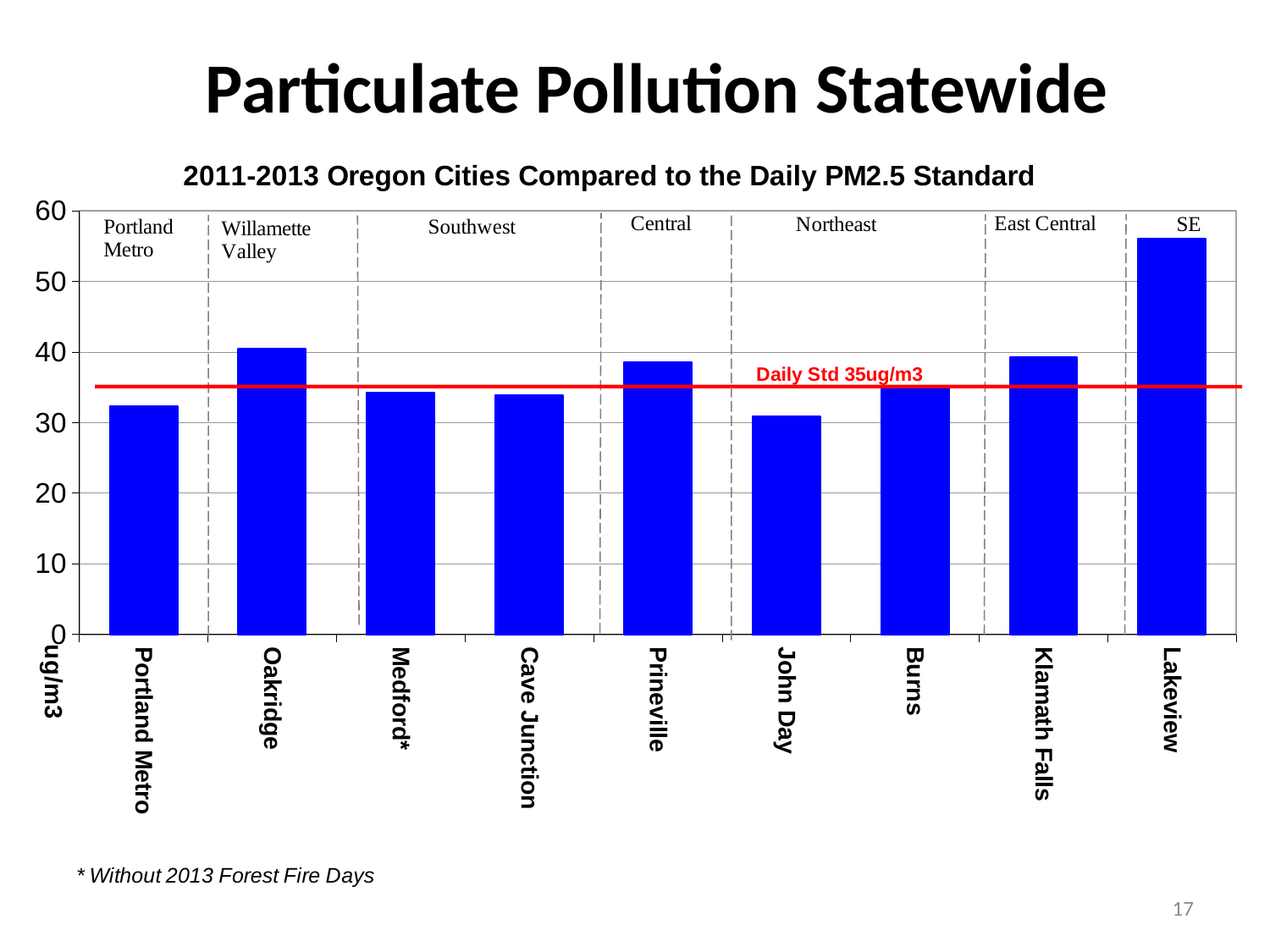
Which is larger, the value for Klamath Falls or the value for John Day? Klamath Falls Which city has the lowest value in the chart? John Day Is the value for Lakeview greater or less than 50? greater What kind of chart is shown on the slide? bar chart Which city has the highest value in the chart? Lakeview Which is larger, the value for Oakridge or the value for Portland Metro? Oakridge What is the title of the chart? 2011-2013 Oregon Cities Compared to the Daily PM2.5 Standard What value does the red horizontal line in the chart represent? Daily Std 35ug/m3 How many cities are plotted in the chart? 9 Is the value for Portland Metro greater or less than 40? less Is the value for Klamath Falls greater or less than 50? less